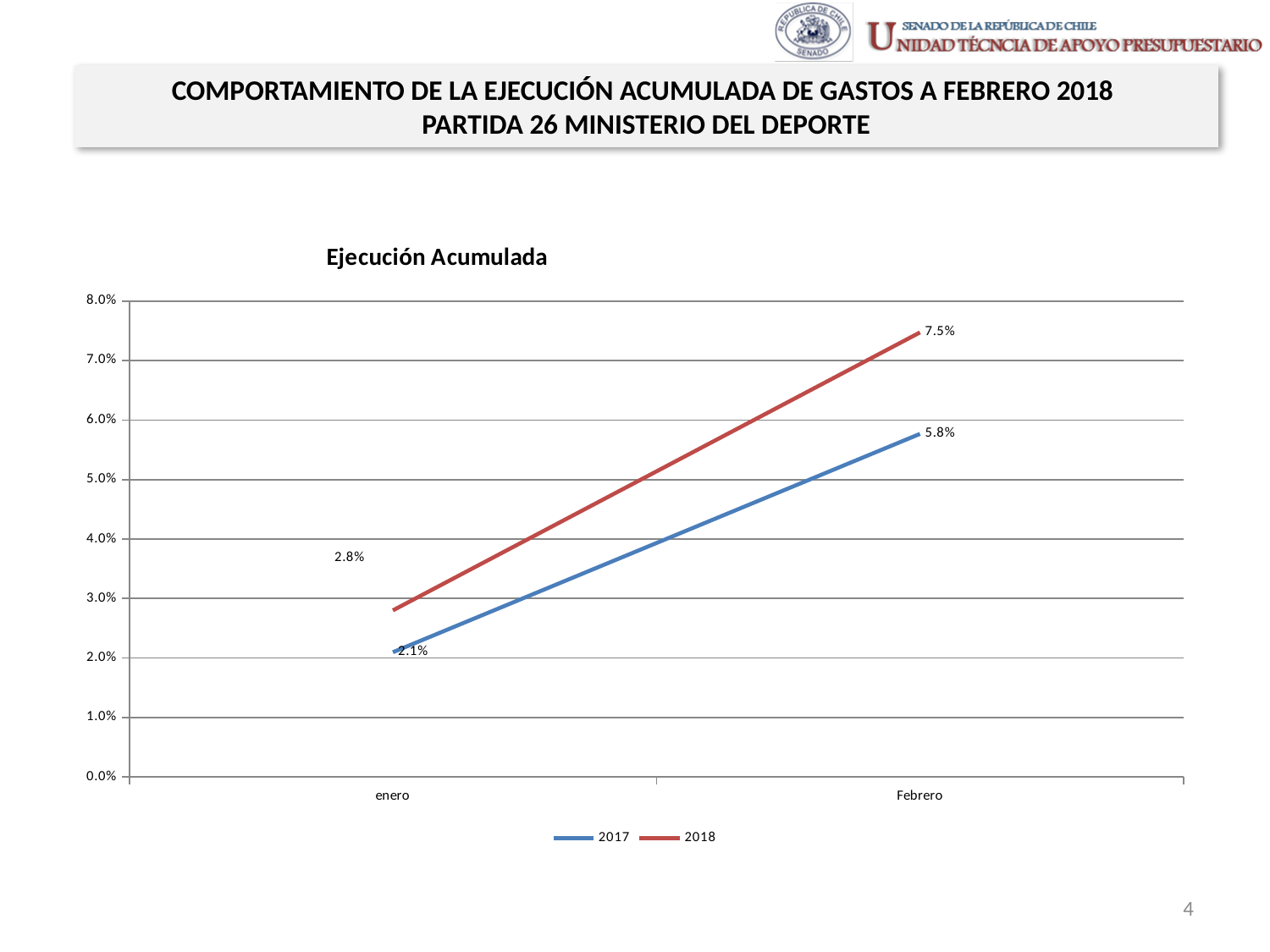
How many series does the legend list? 2 How many categories are shown on the x axis? 2 What is the difference between the 2018 and 2017 values in Febrero? 1.7% Which series has the higher value in Febrero, 2017 or 2018? 2018 What is the title of the chart? Ejecución Acumulada What is the value for 2017 in Febrero? 5.8% Does the 2017 series rise or fall from enero to Febrero? Rise What is the value for 2018 in enero? 2.8% What is the value for 2018 in Febrero? 7.5% What type of chart is shown on the slide? Line chart What is the value for 2017 in enero? 2.1% Which colour is used for the 2018 series? Red